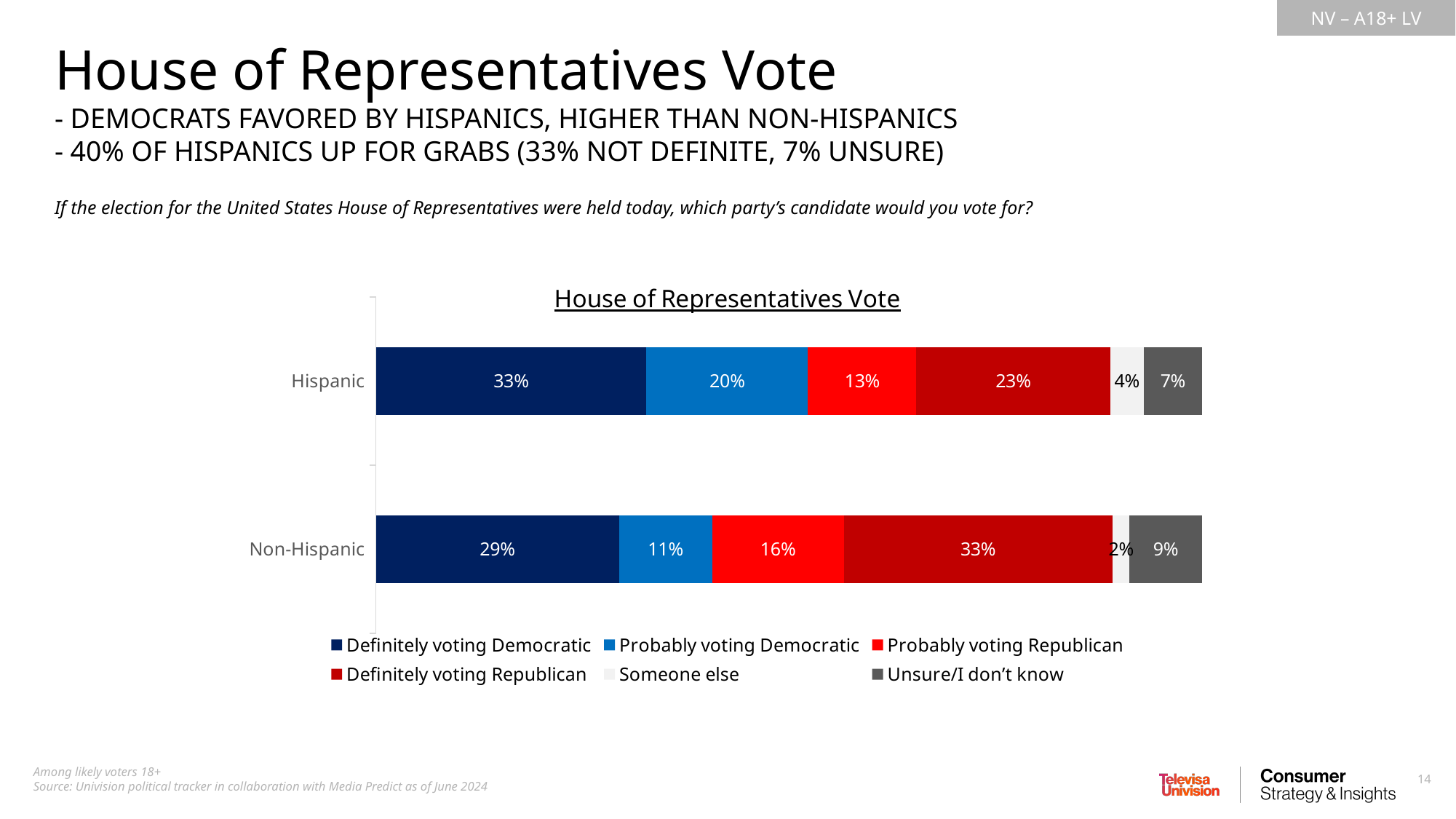
What kind of chart is shown on the slide? Stacked bar chart What is the difference between the Hispanic and Non-Hispanic shares for 'Definitely voting Republican'? 10% What percentage of Hispanic respondents are definitely voting Democratic? 33% Which response category has the largest share among Non-Hispanic respondents? Definitely voting Republican How many groups (categories) are shown on the chart? 2 Which response category has the smallest share among Hispanic respondents? Someone else What percentage of Non-Hispanic respondents are unsure/don't know? 9% What percentage of Non-Hispanic respondents are probably voting Democratic? 11% What percentage of Hispanic respondents are definitely voting Republican? 23% Which group has the larger share for 'Probably voting Democratic', Hispanic or Non-Hispanic? Hispanic How many series does the legend list? 6 Which group has the larger share for 'Probably voting Republican', Hispanic or Non-Hispanic? Non-Hispanic